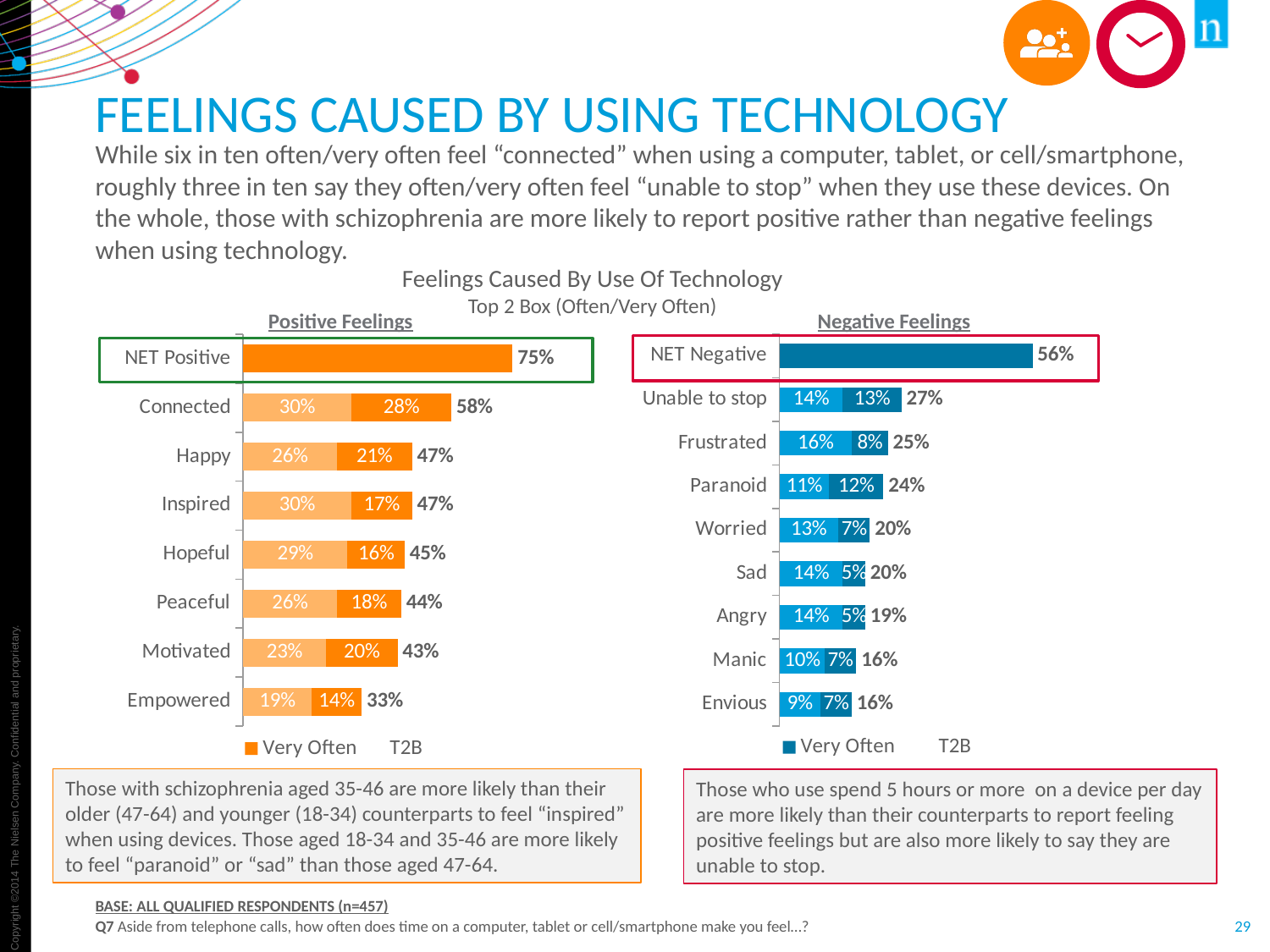
In the Negative Feelings chart, what is the T2B value for Unable to stop? 27% What type of chart is used for the Positive Feelings and Negative Feelings data? Bar chart In the Negative Feelings chart, what is the value shown for NET Negative? 56% In the Positive Feelings chart, what is the T2B value for Connected? 58% In the Positive Feelings chart, what is the difference between the T2B values for Connected and Empowered? 25% In the Positive Feelings chart, which individual feeling (excluding NET Positive) has the lowest T2B value? Empowered In the Positive Feelings chart, what is the value shown for NET Positive? 75% In the Negative Feelings chart, which has a larger T2B value, Frustrated or Worried? Frustrated In the Positive Feelings chart, how many individual feelings are listed below NET Positive? 7 In the Negative Feelings chart, how many individual feelings are listed below NET Negative? 8 In the Negative Feelings chart, which individual feeling (excluding NET Negative) has the highest T2B value? Unable to stop What is the difference between the NET Positive and NET Negative values? 19%